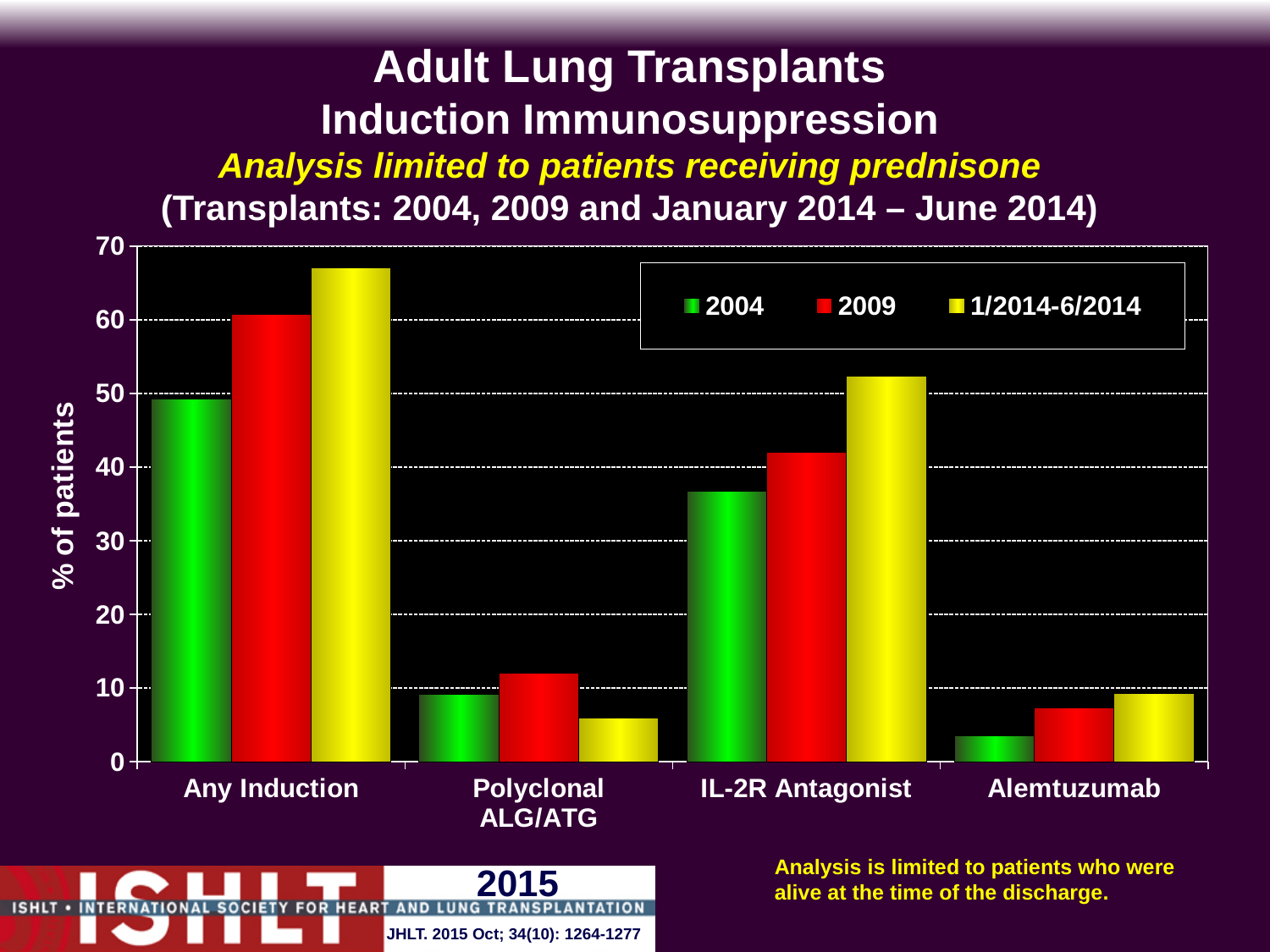
How many induction categories are shown on the x axis? 4 How many series does the legend list? 3 Which category has the lowest value for 2004? Alemtuzumab For IL-2R Antagonist, which is larger: the 2004 value or the 2009 value? 2009 For Alemtuzumab, do the values rise or fall from 2004 to 2009 to 1/2014-6/2014? rise Is the value for Any Induction in 2009 greater or less than 50? greater Is the value for IL-2R Antagonist in 1/2014-6/2014 greater or less than 40? greater For Polyclonal ALG/ATG, which is larger: the 2004 value or the 1/2014-6/2014 value? 2004 What kind of chart is shown on the slide? bar chart What is the label on the y axis? % of patients Which category has the highest value for 1/2014-6/2014? Any Induction Is the value for Alemtuzumab in 2004 greater or less than 10? less